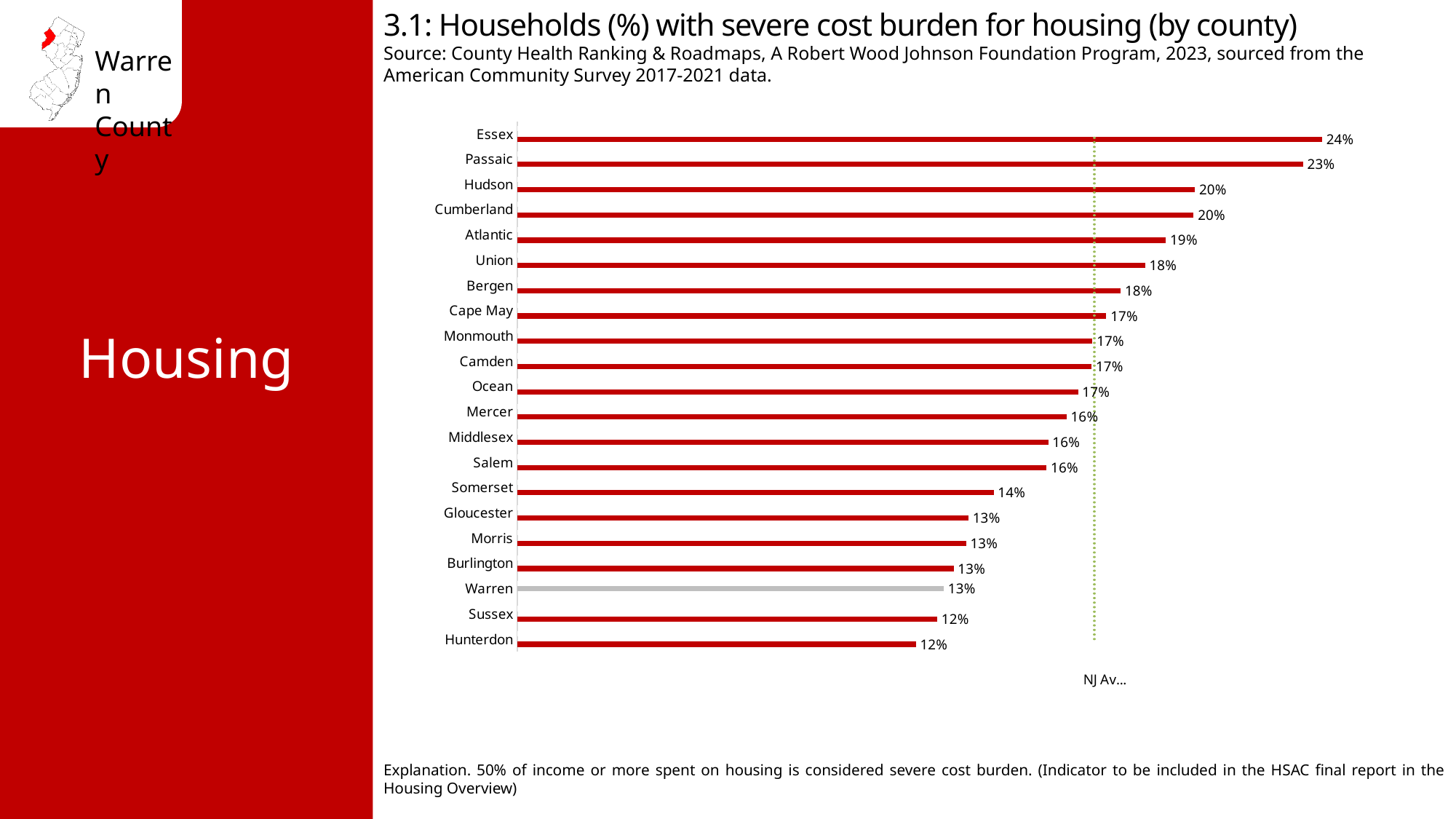
Which county's bar is shown in grey instead of red? Warren What is the value shown for Passaic County? 23% Do the values increase or decrease going from the top county to the bottom county? Decrease What is the difference in percentage points between Essex County and Warren County? 11 percentage points Which has a higher value, Atlantic County or Somerset County? Atlantic What percentage of households in Essex County have a severe cost burden for housing? 24% What is the value for Warren County in the chart? 13% What kind of chart is shown on the slide? Bar chart What is the value shown for Somerset County? 14% What does the dotted vertical line in the chart represent? NJ Average Which county has the highest percentage of households with severe housing cost burden? Essex How many counties are shown in the chart? 21